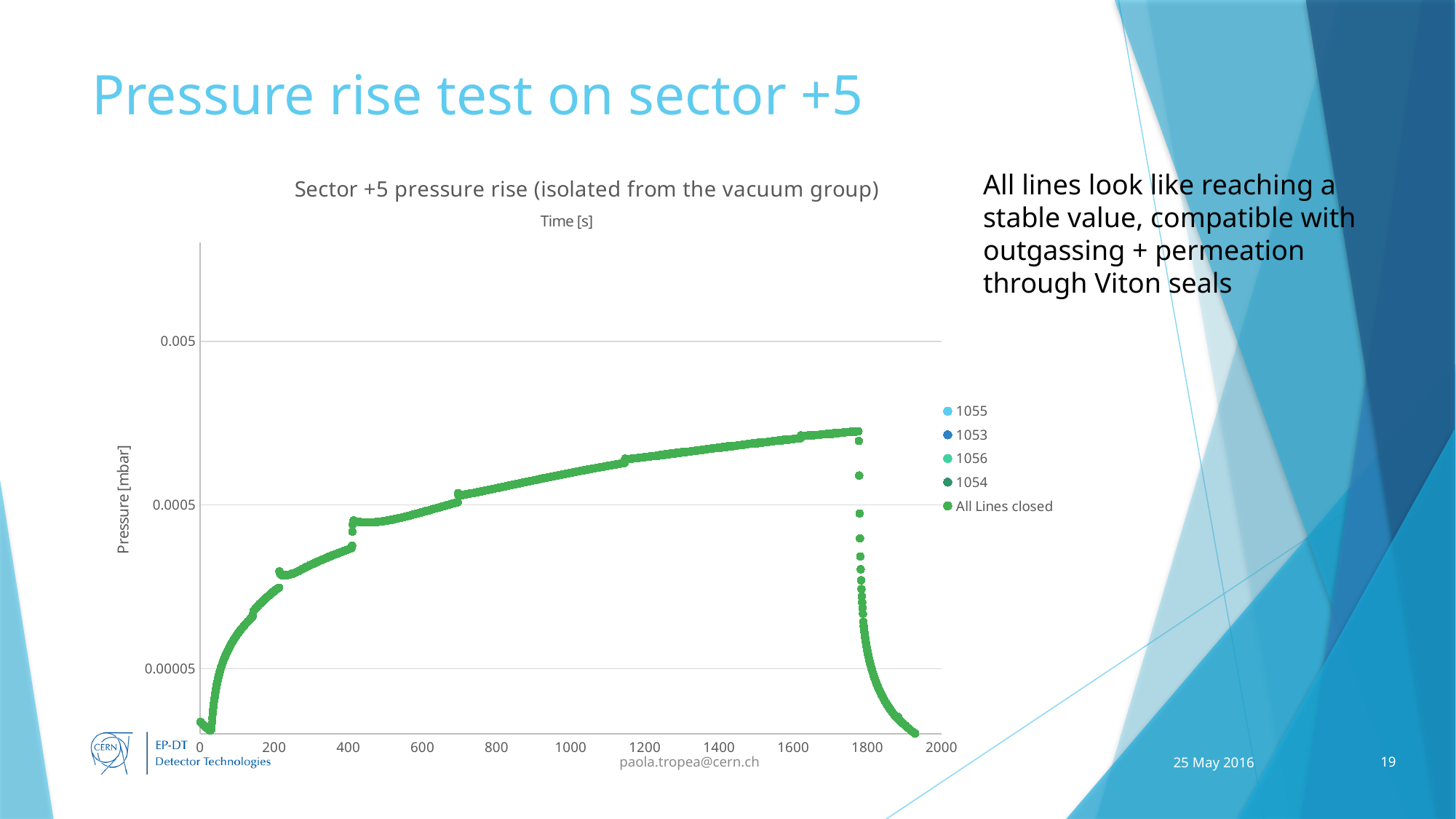
Is the highest pressure reached on the chart greater or less than 0.005 mbar? less What kind of chart is shown on the slide? scatter chart Is the pressure at a time of 200 s greater or less than 0.0005 mbar? less Is the pressure at a time of 1000 s greater or less than 0.0005 mbar? greater Does the pressure rise or fall between 1800 s and 1900 s? fall What is the title of the chart? Sector +5 pressure rise (isolated from the vacuum group) What is the label of the vertical axis? Pressure [mbar] Which is larger, the pressure at 400 s or the pressure at 1400 s? 1400 s How many series does the legend list? 5 What is the highest tick value shown on the horizontal (Time) axis? 2000 Does the pressure rise or fall between 0 s and 1600 s? rise